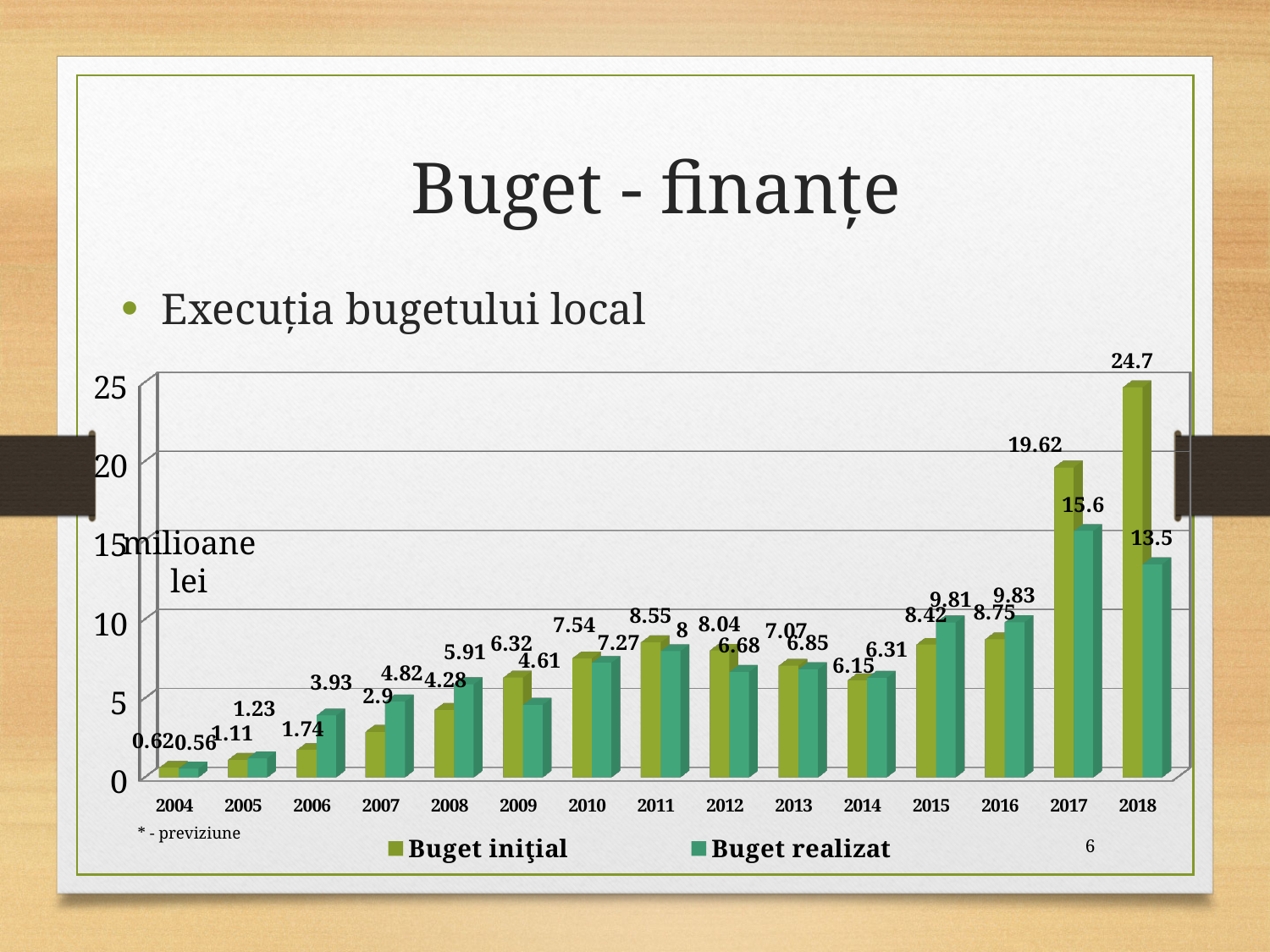
What is the value of Buget iniţial for 2018? 24.7 What unit is shown on the vertical axis of the chart? milioane lei In 2009, which is larger: Buget iniţial or Buget realizat? Buget iniţial Is the Buget iniţial value for 2017 greater or less than 15? greater How many years are shown on the x axis? 15 What is the difference between Buget iniţial and Buget realizat in 2018? 11.2 What kind of chart is shown on the slide? Bar chart How many series does the legend list? 2 Which year has the lowest Buget realizat value? 2004 Which year has the highest Buget iniţial value? 2018 What is the value of Buget realizat for 2017? 15.6 What is the value of Buget realizat for 2006? 3.93